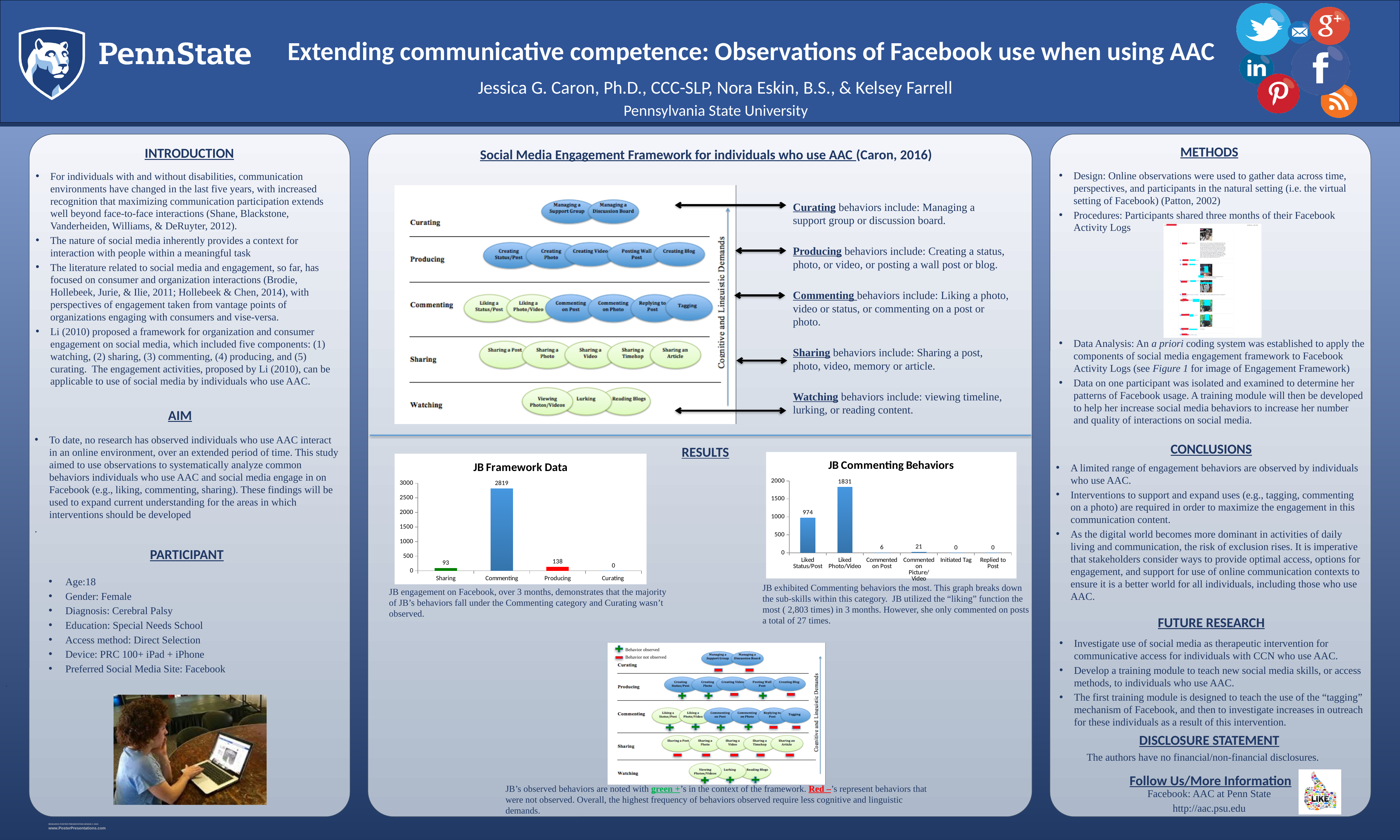
In the JB Commenting Behaviors chart, what is the value for Liked Photo/Video? 1831 In the JB Commenting Behaviors chart, which category has the highest value? Liked Photo/Video In the JB Framework Data chart, what is the value for Commenting? 2819 In the JB Commenting Behaviors chart, what is the value for Commented on Picture/Video? 21 In the JB Framework Data chart, which category has the highest value? Commenting In the JB Framework Data chart, how many categories are shown on the x axis? 4 In the JB Framework Data chart, what is the value for Sharing? 93 In the JB Framework Data chart, which category has the lowest value? Curating In the JB Commenting Behaviors chart, what is the difference between Liked Photo/Video and Liked Status/Post? 857 What kind of chart is the JB Framework Data chart? Bar chart In the JB Framework Data chart, what is the difference between Producing and Sharing? 45 In the JB Commenting Behaviors chart, which is larger, Commented on Post or Commented on Picture/Video? Commented on Picture/Video